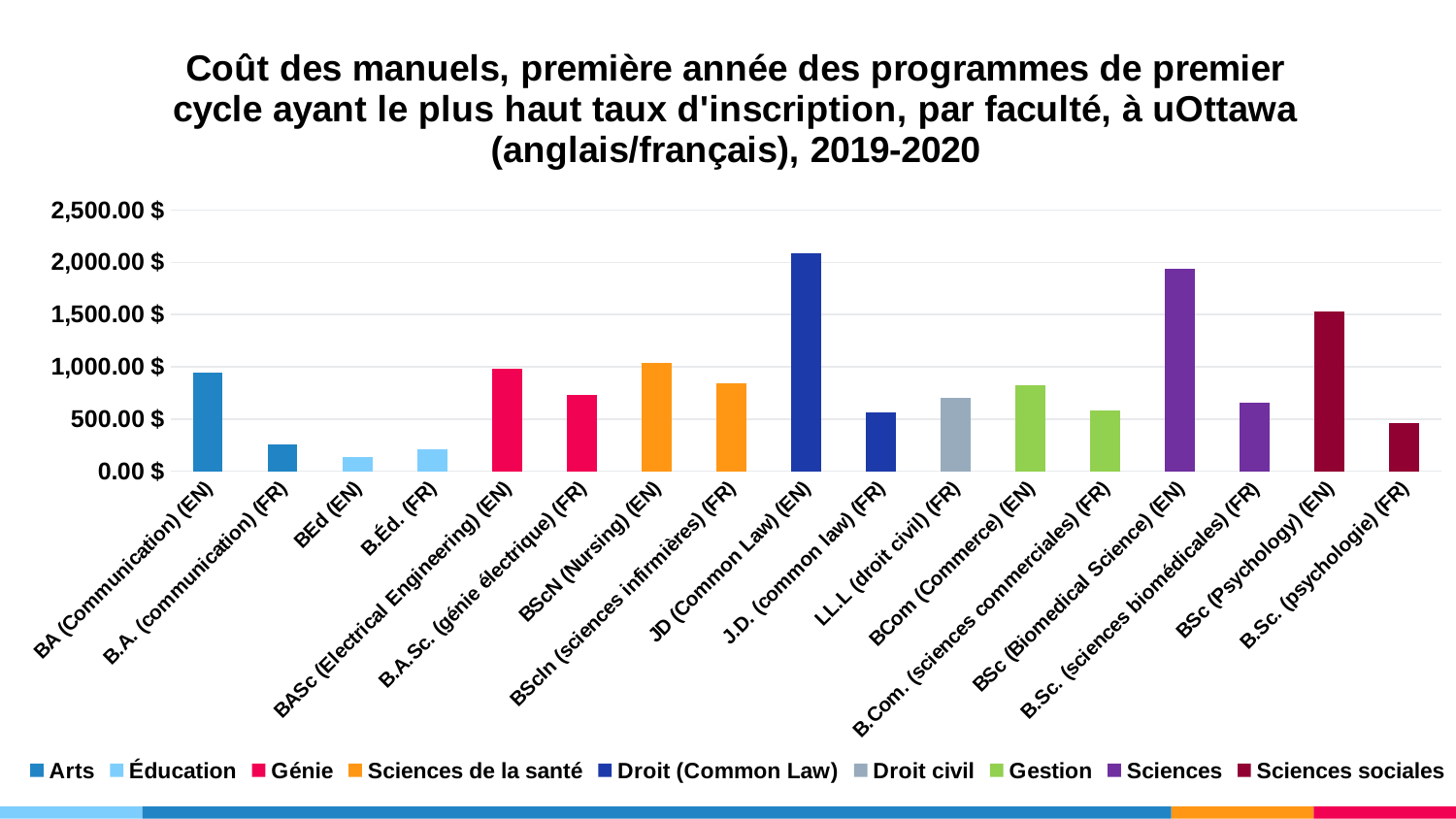
What type of chart is shown on the slide? bar chart How many faculties does the legend list? 9 Is the value for BSc (Psychology) (EN) greater or less than 1,000.00 $? greater Which program has the lowest textbook cost? BEd (EN) Is the value for B.A. (communication) (FR) greater or less than 500.00 $? less Which faculty does the legend associate with the purple bars? Sciences Which is larger, the value for JD (Common Law) (EN) or J.D. (common law) (FR)? JD (Common Law) (EN) Is the value for B.A.Sc. (génie électrique) (FR) greater or less than 1,000.00 $? less Which program has the highest textbook cost? JD (Common Law) (EN) Which is larger, the value for BSc (Biomedical Science) (EN) or BSc (Psychology) (EN)? BSc (Biomedical Science) (EN) How many programs (bars) are plotted in the chart? 17